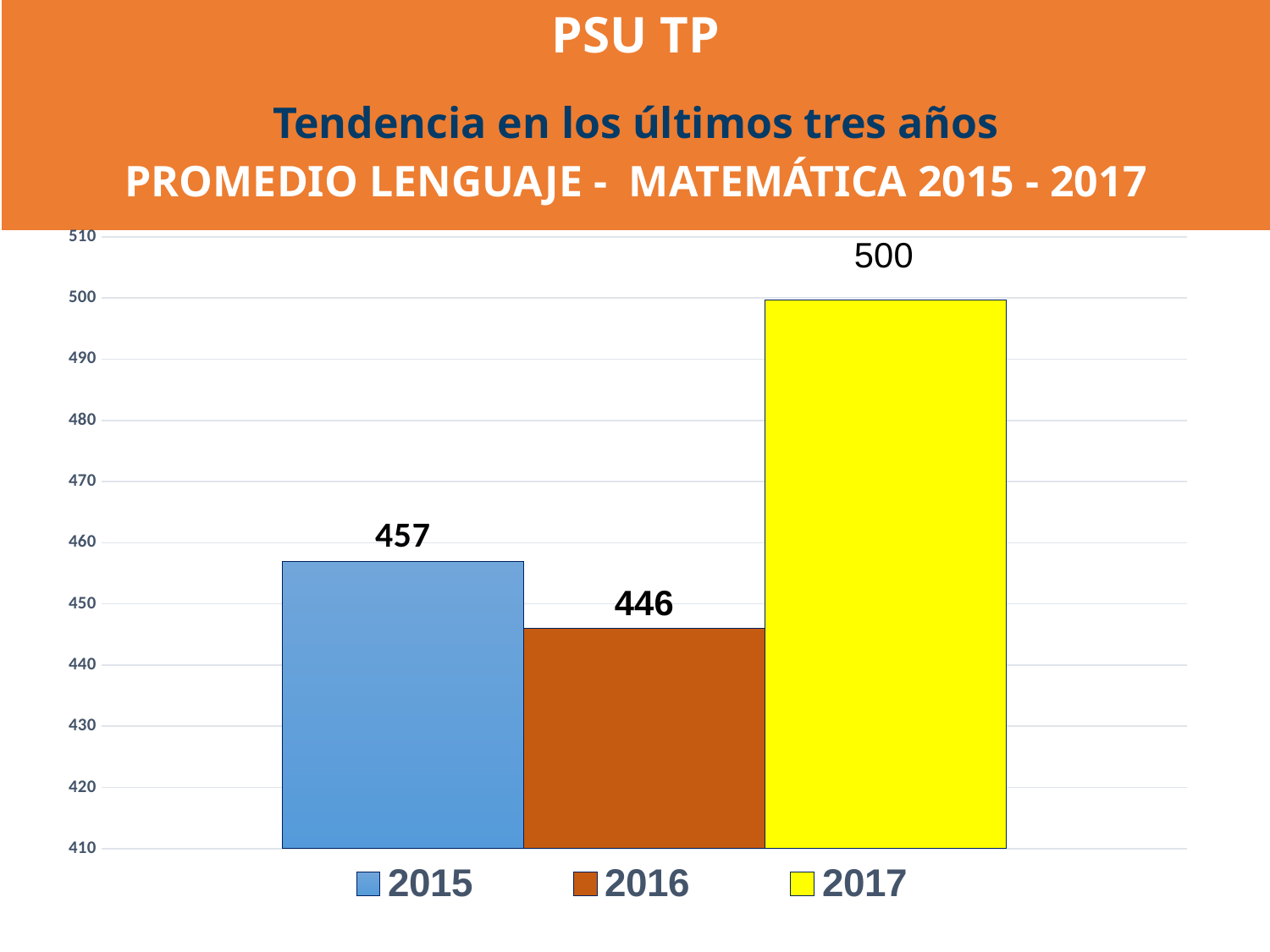
What is the value for 2016? 446 What is the value for 2017? 500 What is the difference between the values for 2015 and 2016? 11 What colour is the bar for 2017? yellow What kind of chart is shown on the slide? bar chart How many series does the legend list? 3 Is the value for 2016 greater or less than 450? less Which year has the highest value? 2017 What is the difference between the values for 2017 and 2016? 54 Which is larger, the value for 2015 or the value for 2016? 2015 Which year has the lowest value? 2016 What is the value for 2015? 457